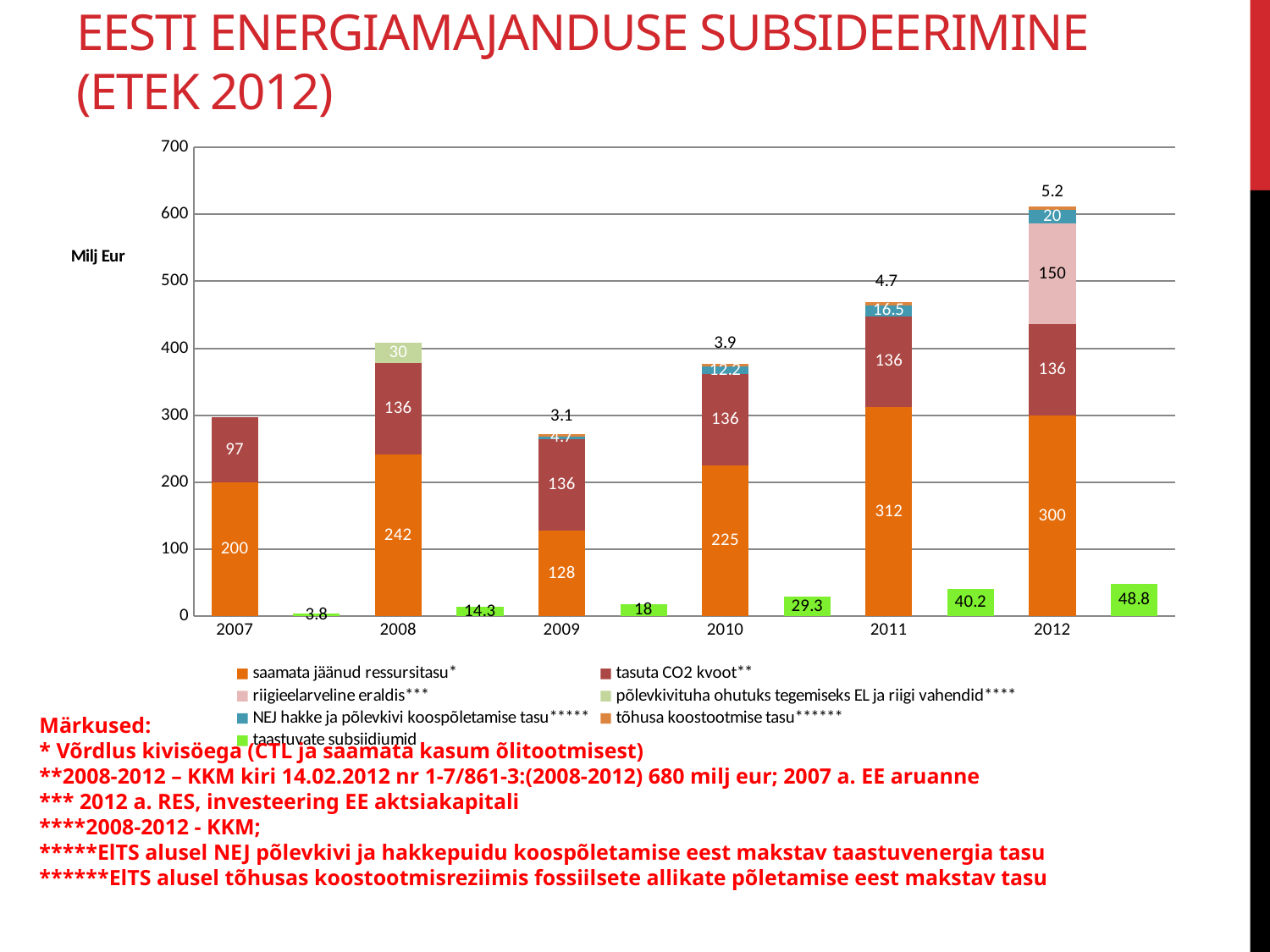
What is the value of tasuta CO2 kvoot for 2007? 97 How many series does the legend list? 7 What is the value of riigieelarveline eraldis in 2012? 150 What is the total of the stacked bar for 2007? 297 Is the total of the stacked bar for 2011 greater or less than 500? less Which year has the lowest value for saamata jäänud ressursitasu? 2009 What is the difference between the saamata jäänud ressursitasu values for 2011 and 2010? 87 What is the value of taastuvate subsiidiumid for 2012? 48.8 Which year has the larger tasuta CO2 kvoot value, 2007 or 2008? 2008 Which year has the highest value for taastuvate subsiidiumid? 2012 How many years are shown on the x axis? 6 What is the value of saamata jäänud ressursitasu for 2011? 312